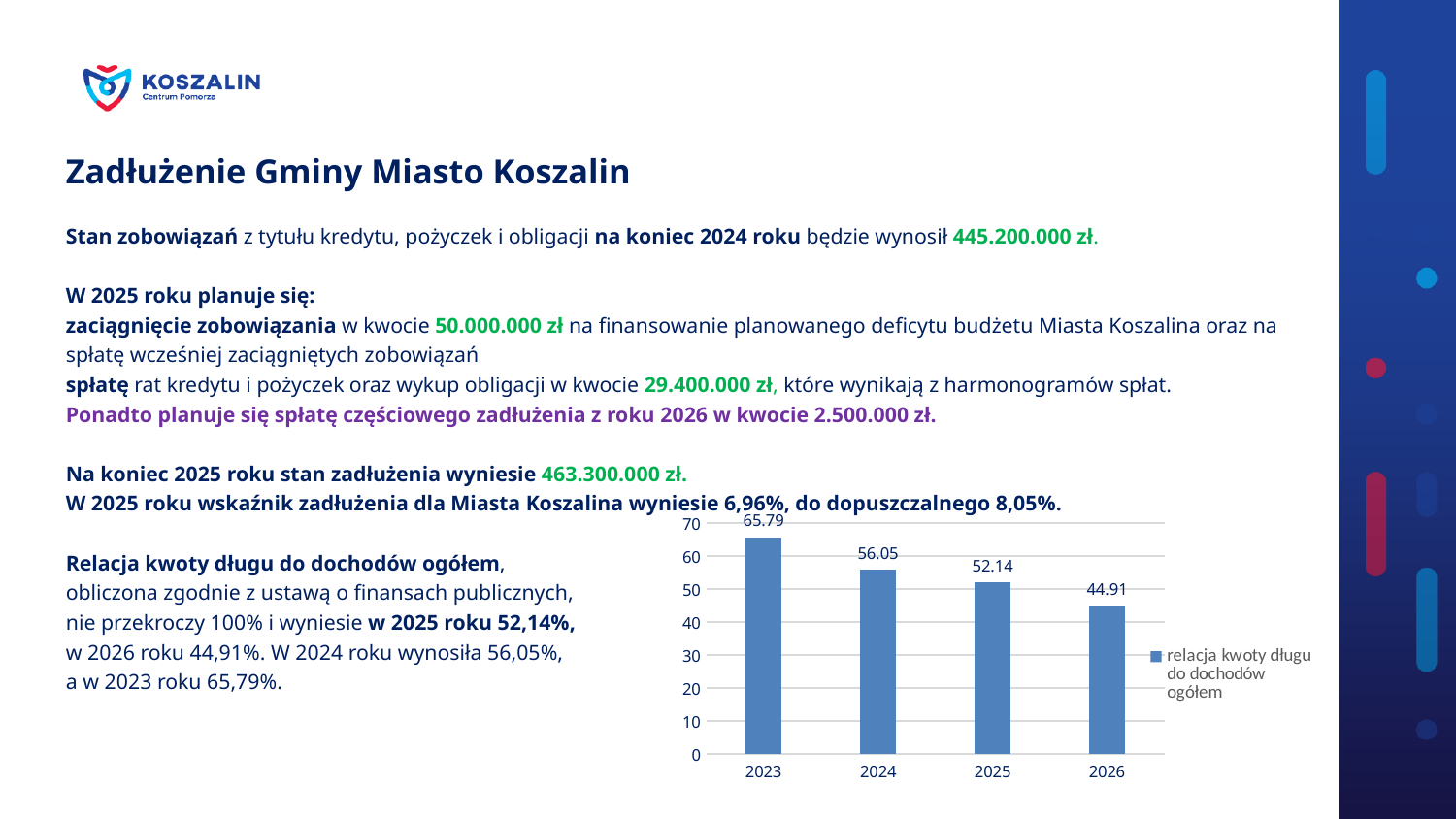
What is the value for 2023 in the chart? 65.79 What is the difference between the values for 2023 and 2026? 20.88 How many years are shown on the x axis of the chart? 4 What is the value for 2026 in the chart? 44.91 Which is larger, the value for 2024 or the value for 2025? 2024 Which year has the highest value in the chart? 2023 What kind of chart is shown on the slide? bar chart Which year has the lowest value in the chart? 2026 What is the value for 2024 in the chart? 56.05 Is the value for 2026 greater or less than 50? less Do the values rise or fall from 2023 to 2026? fall What is the value for 2025 in the chart? 52.14